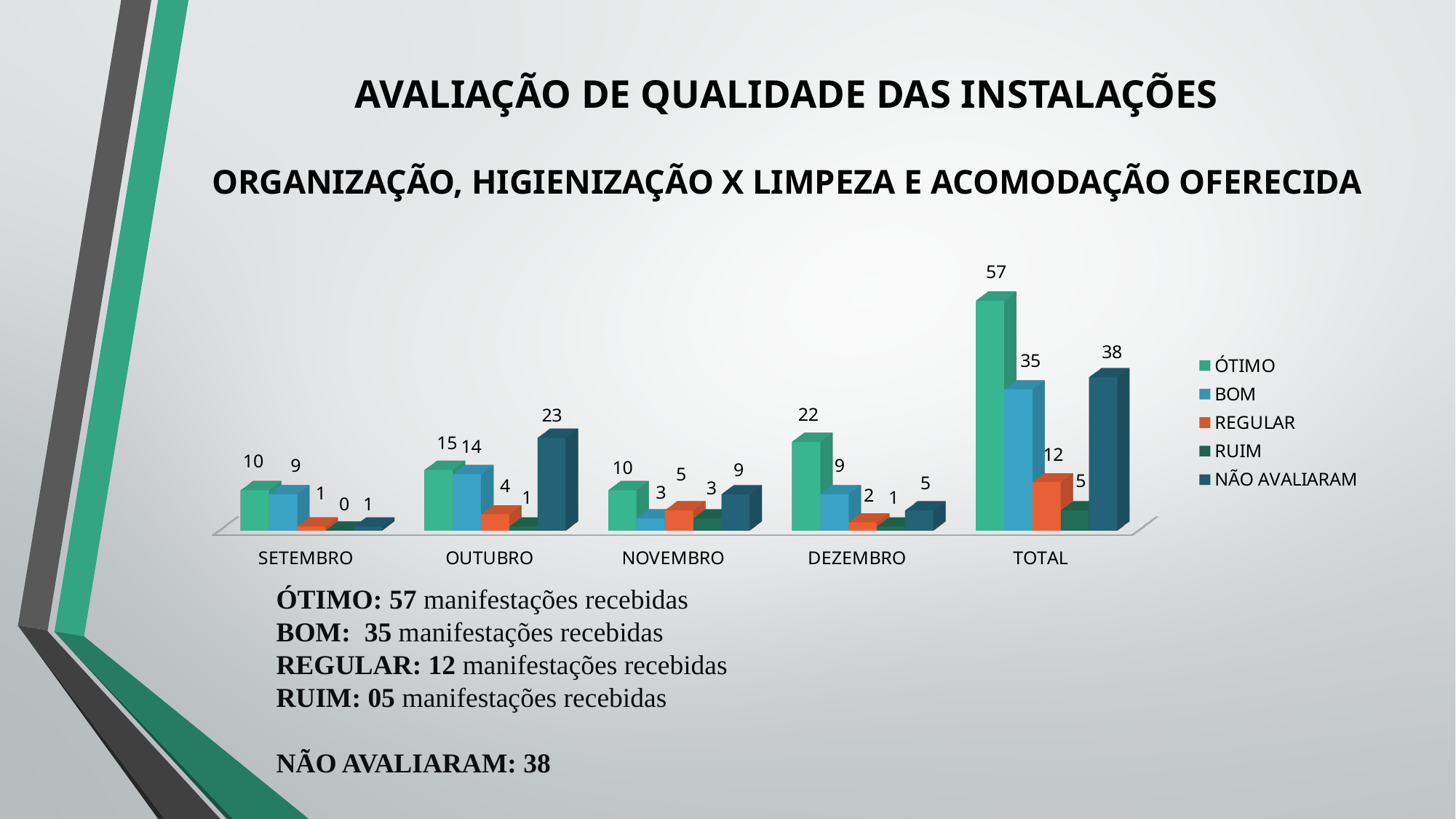
What is the value for BOM in NOVEMBRO? 3 What is the difference between the ÓTIMO and BOM values in the TOTAL category? 22 Which series has the lowest value in the TOTAL category? RUIM How many categories are shown on the x axis? 5 Which is larger in OUTUBRO: the ÓTIMO value or the NÃO AVALIARAM value? NÃO AVALIARAM How many series does the legend list? 5 What kind of chart is shown on the slide? Bar chart What is the value for ÓTIMO in DEZEMBRO? 22 What is the value for RUIM in SETEMBRO? 0 What is the value for NÃO AVALIARAM in OUTUBRO? 23 Which legend entry is shown in orange? REGULAR In which month (excluding TOTAL) is the ÓTIMO value highest? DEZEMBRO